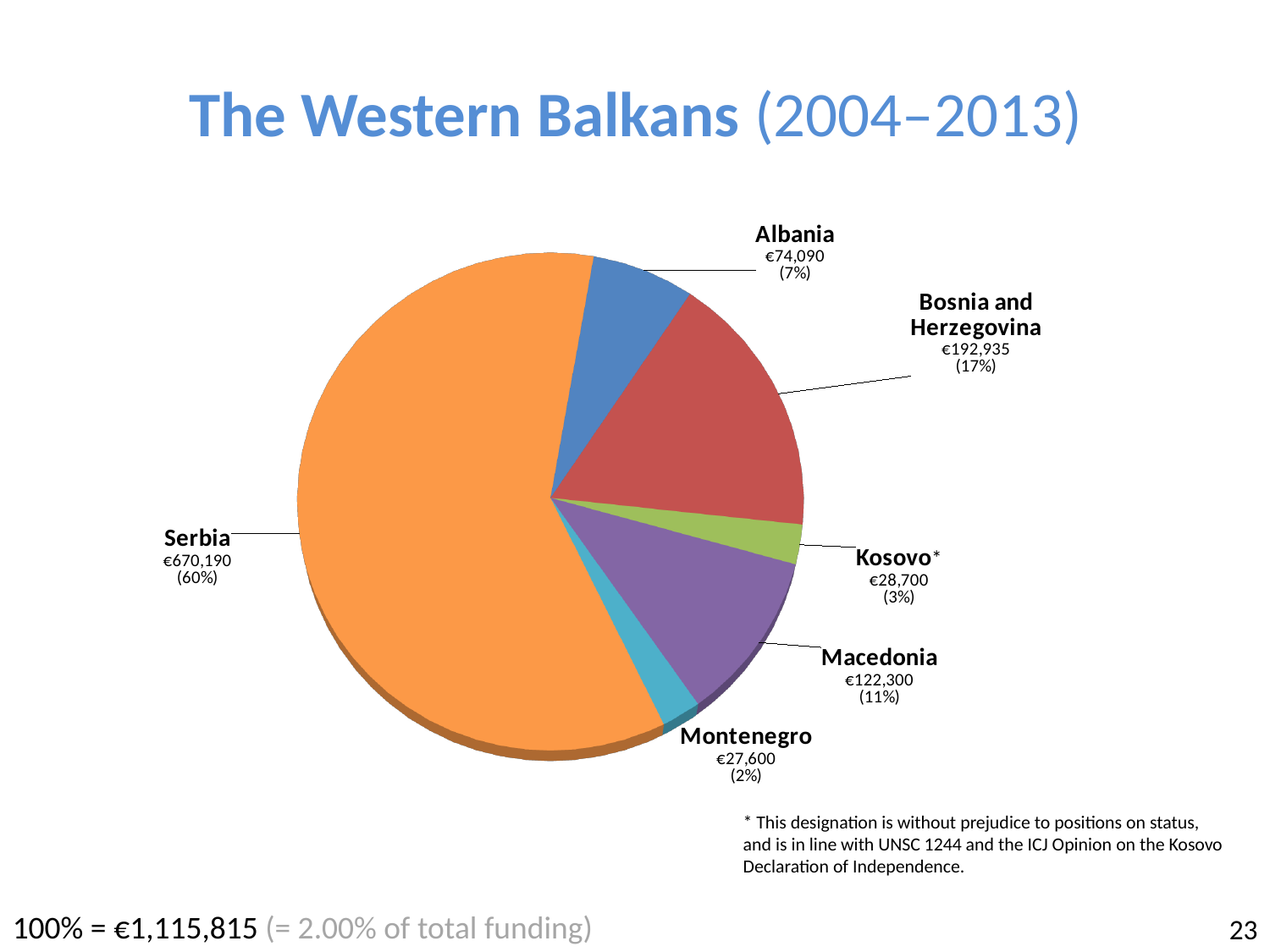
Which country has the smallest slice of the pie? Montenegro What type of chart is shown on the slide? pie chart What is the value for Montenegro? €27,600 Which country has the largest slice of the pie? Serbia What share of the pie does Kosovo represent? 3% What share of the pie does Albania represent? 7% Which is larger, the value for Albania or the value for Kosovo? Albania What is the value for Serbia? €670,190 How many countries are shown in the pie chart? 6 What is the value for Macedonia? €122,300 What is the difference between the values for Bosnia and Herzegovina and Macedonia? €70,635 What is the value for Bosnia and Herzegovina? €192,935